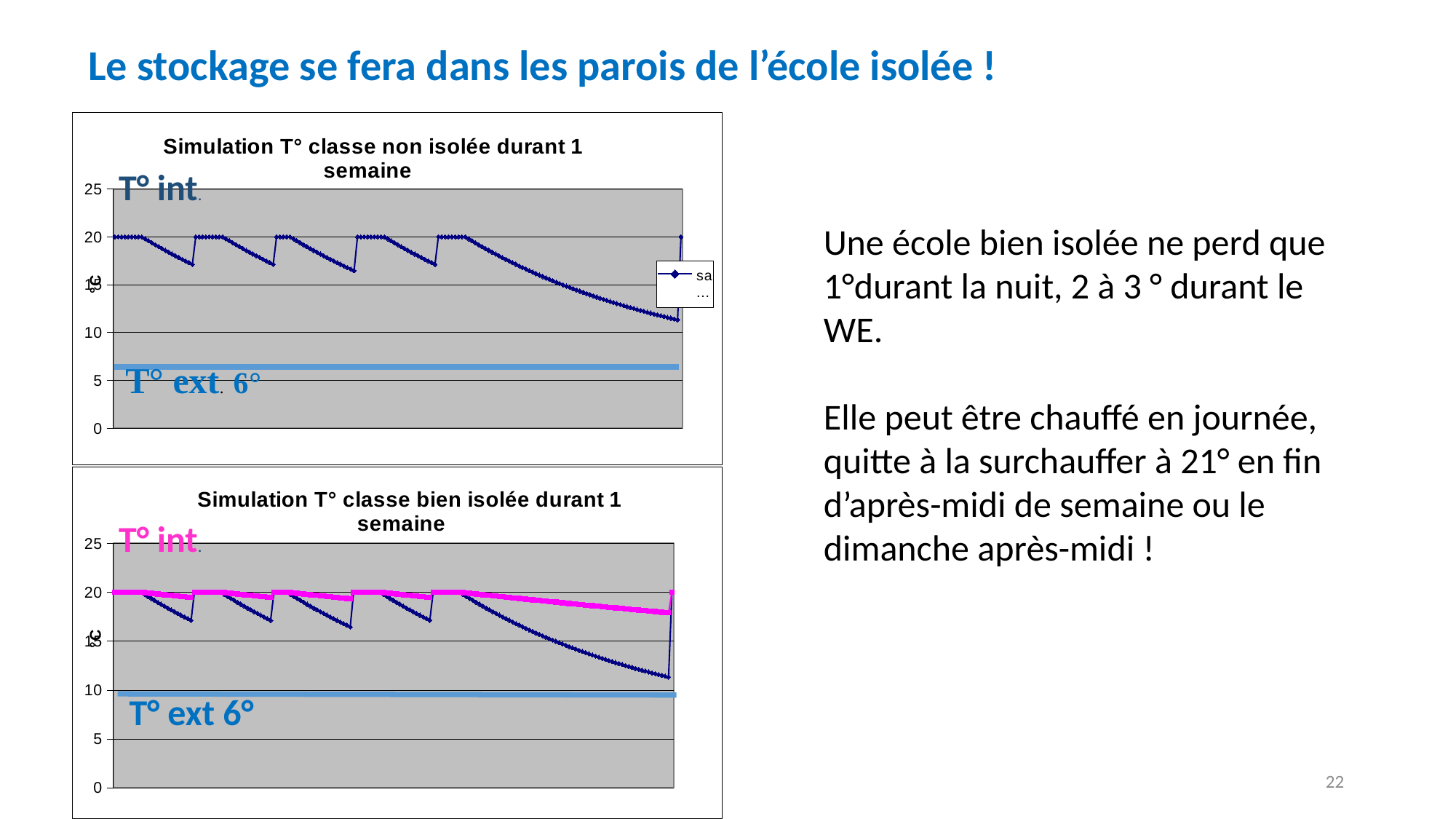
In the top chart, is the value of the dark blue T° int. line at the end of the week (before the final jump) greater or less than 15? less What is the title of the bottom chart? Simulation T° classe bien isolée durant 1 semaine What kind of chart is the top chart, 'Simulation T° classe non isolée durant 1 semaine'? line chart What is the title of the top chart? Simulation T° classe non isolée durant 1 semaine What is the highest value shown on the y axis of the top chart? 25 According to the label on the bottom chart, what is the external temperature (T° ext)? 6° In the bottom chart, at the end of the week, which line is higher: the magenta line or the dark blue line? the magenta line In the top chart, does the dark blue T° int. line overall rise or fall across the week? fall What kind of chart is the bottom chart, 'Simulation T° classe bien isolée durant 1 semaine'? line chart In the top chart, is the value of the dark blue T° int. line at the start of the week greater or less than 15? greater In the bottom chart, is the magenta T° int. line at the end of the week greater or less than 15? greater